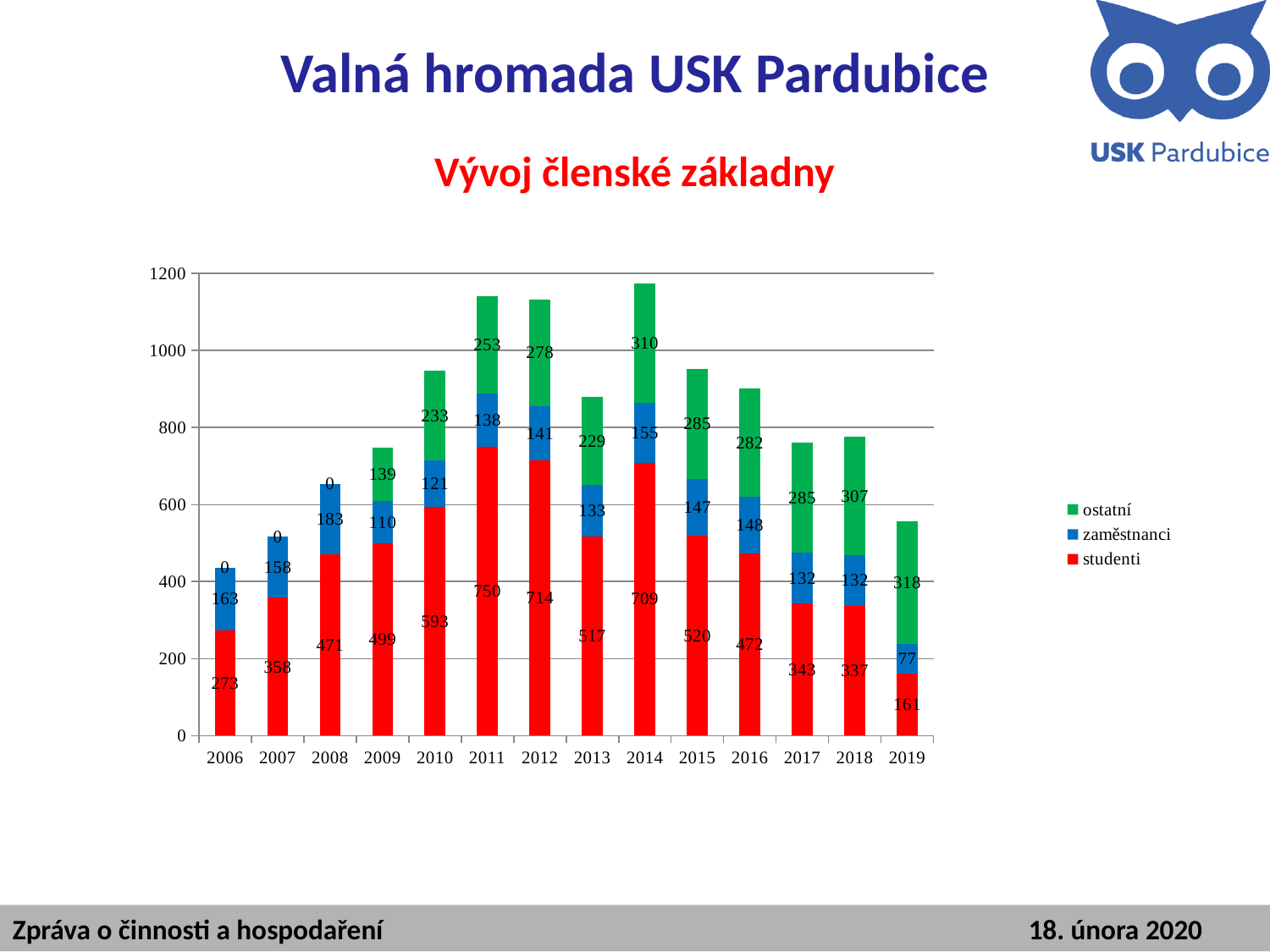
In which year is the studenti value highest? 2011 How many years are shown on the x axis? 14 How many series does the legend list? 3 What is the difference between the studenti value in 2011 and in 2019? 589 What is the value for zaměstnanci in 2008? 183 What is the value for ostatní in 2019? 318 What kind of chart is shown on the slide? stacked bar chart In which year is the studenti value lowest? 2019 Which is larger, the ostatní value in 2014 or in 2018? 2014 Is the total of the stacked bar for 2014 greater or less than 1000? greater What is the total of the stacked bar for 2014? 1174 What is the value for studenti in 2011? 750